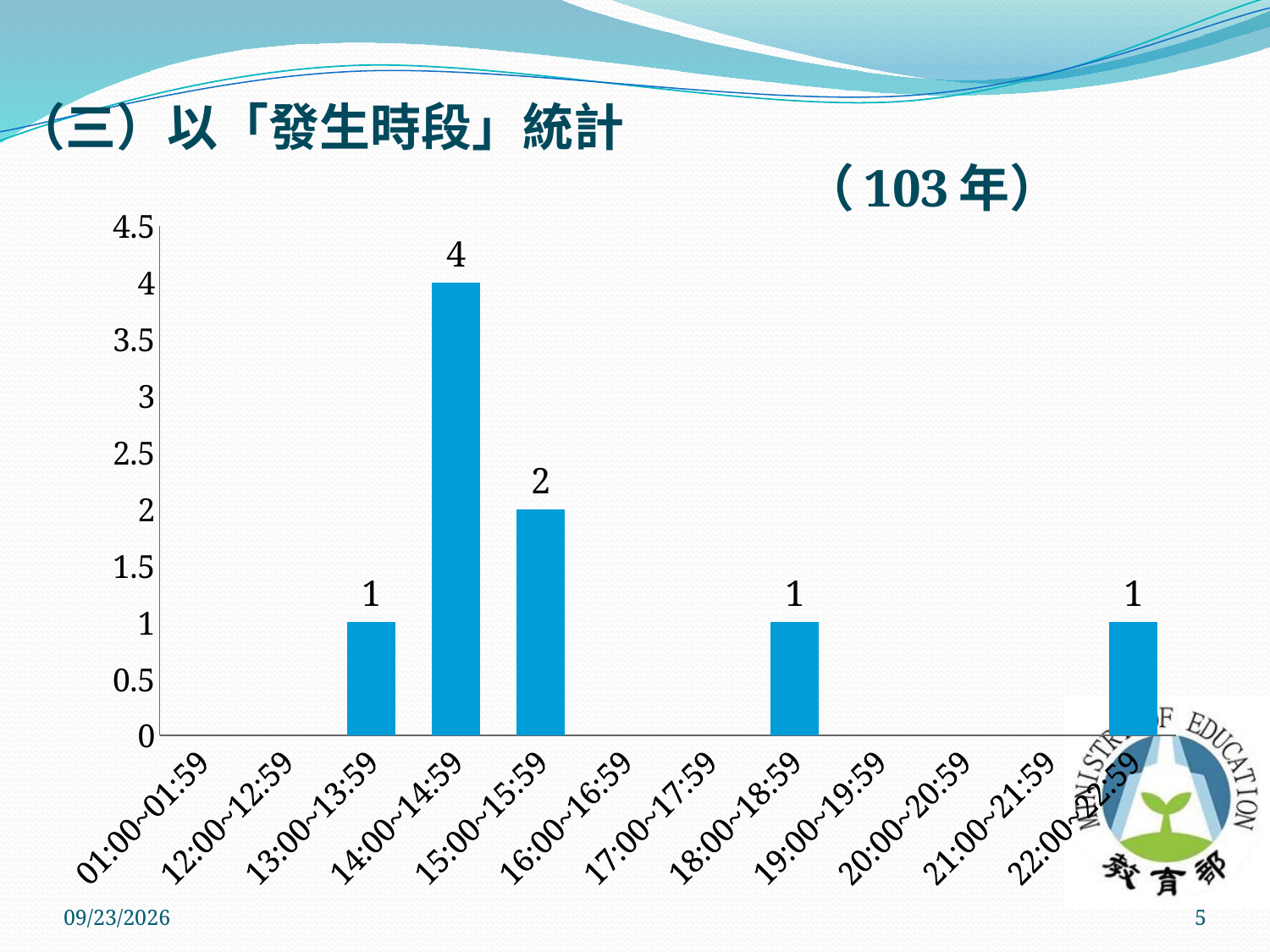
What is the value for the 18:00~18:59 time slot? 1 How many time-slot categories are shown on the x axis? 12 What is the value for the 14:00~14:59 time slot? 4 What is the value for the 15:00~15:59 time slot? 2 Is the value for 14:00~14:59 greater or less than 3? greater Which time slot has the highest value? 14:00~14:59 What is the difference between the values for 14:00~14:59 and 15:00~15:59? 2 What is the value for the 13:00~13:59 time slot? 1 What is the difference between the values for 15:00~15:59 and 18:00~18:59? 1 Which is larger, the value for 14:00~14:59 or the value for 15:00~15:59? 14:00~14:59 What is the maximum value shown on the y axis? 4.5 What kind of chart is shown on the slide? bar chart